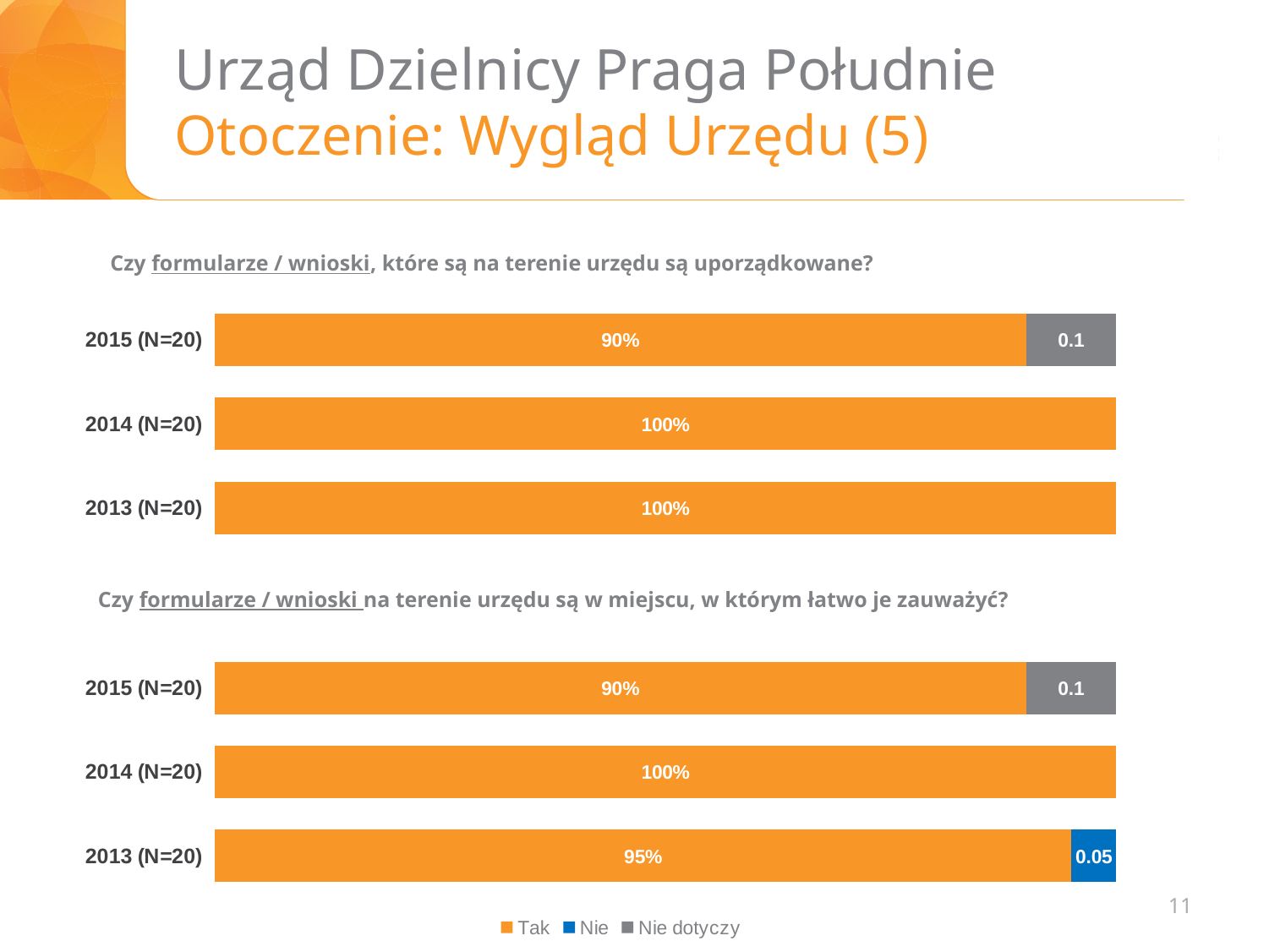
In the top chart ("Czy formularze / wnioski, które są na terenie urzędu są uporządkowane?"), what is the "Tak" value for 2014 (N=20)? 100% In the bottom chart ("Czy formularze / wnioski na terenie urzędu są w miejscu, w którym łatwo je zauważyć?"), which is larger: the "Tak" value for 2013 (N=20) or for 2015 (N=20)? 2013 (N=20) In the top chart ("Czy formularze / wnioski, które są na terenie urzędu są uporządkowane?"), what is the "Tak" value for 2015 (N=20)? 90% How many series does the legend at the bottom of the slide list? 3 In the top chart ("Czy formularze / wnioski, które są na terenie urzędu są uporządkowane?"), what value is shown for the grey "Nie dotyczy" segment in 2015 (N=20)? 0.1 In the bottom chart ("Czy formularze / wnioski na terenie urzędu są w miejscu, w którym łatwo je zauważyć?"), what value is shown for the blue "Nie" segment in 2013 (N=20)? 0.05 How many year categories does the top chart ("Czy formularze / wnioski, które są na terenie urzędu są uporządkowane?") show? 3 In the bottom chart ("Czy formularze / wnioski na terenie urzędu są w miejscu, w którym łatwo je zauważyć?"), which year has the lowest "Tak" value? 2015 (N=20) In the bottom chart ("Czy formularze / wnioski na terenie urzędu są w miejscu, w którym łatwo je zauważyć?"), what is the difference between the "Tak" values for 2014 (N=20) and 2015 (N=20)? 10% In the bottom chart ("Czy formularze / wnioski na terenie urzędu są w miejscu, w którym łatwo je zauważyć?"), what is the "Tak" value for 2013 (N=20)? 95% Which legend entry is shown in orange? Tak What kind of chart is the top chart ("Czy formularze / wnioski, które są na terenie urzędu są uporządkowane?")? Stacked bar chart